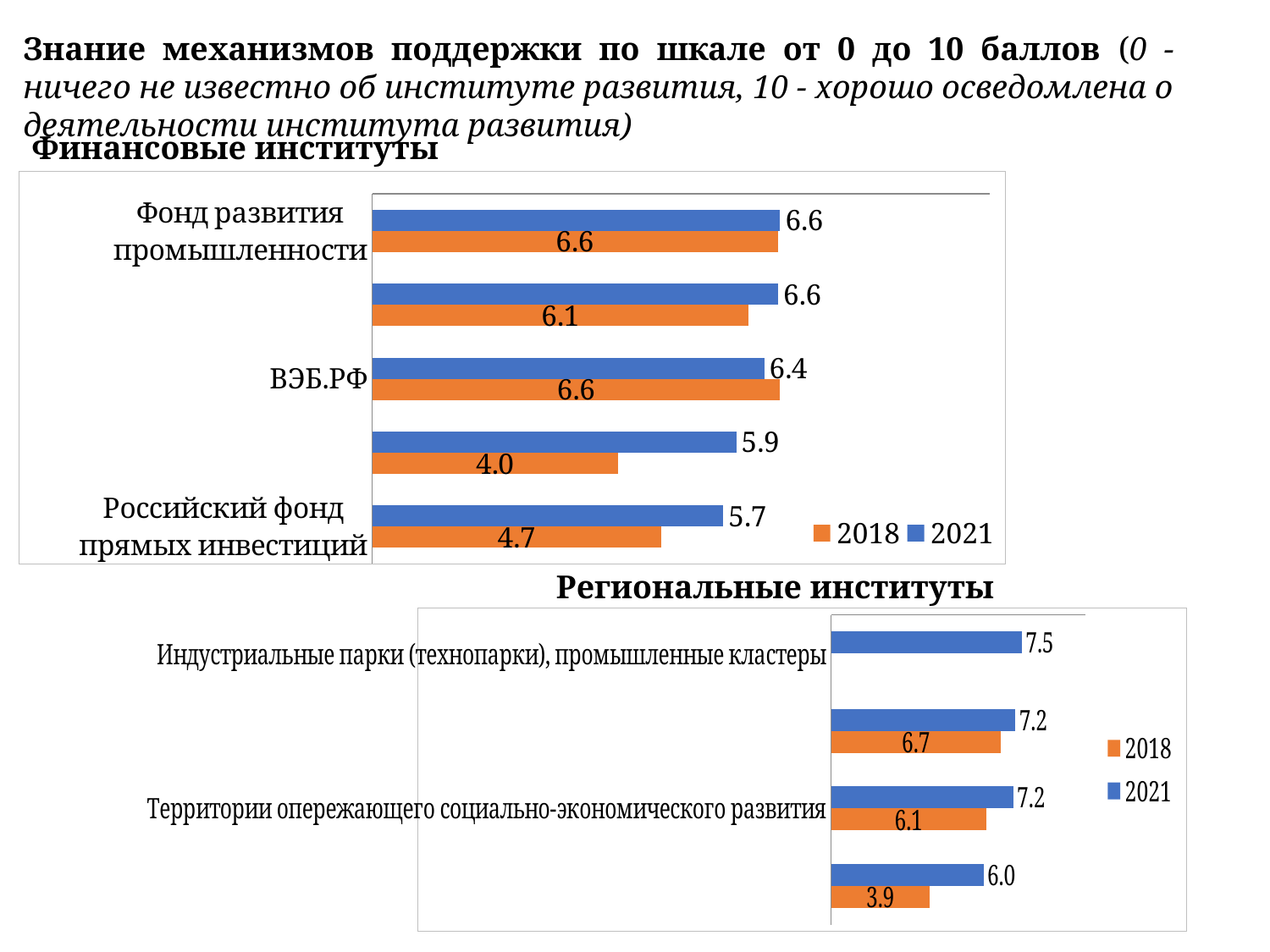
What kind of chart is the 'Региональные институты' chart? Bar chart In the 'Региональные институты' chart, which category has the highest 2021 value? Индустриальные парки (технопарки), промышленные кластеры In the 'Региональные институты' chart, what is the 2021 value for Индустриальные парки (технопарки), промышленные кластеры? 7.5 In the 'Финансовые институты' chart, what is the 2021 value for Фонд развития промышленности? 6.6 How many series does the legend of the 'Финансовые институты' chart list? 2 In the 'Финансовые институты' chart, what is the 2021 value for Российский фонд прямых инвестиций? 5.7 In the 'Финансовые институты' chart, what is the difference between the 2021 and 2018 values for Российский фонд прямых инвестиций? 1.0 In the 'Финансовые институты' chart, what is the 2018 value for ВЭБ.РФ? 6.6 In the 'Региональные институты' chart, what is the difference between the 2021 and 2018 values for Территории опережающего социально-экономического развития? 1.1 Which colour represents the 2018 series in the 'Региональные институты' chart? Orange In the 'Региональные институты' chart, what is the 2018 value for Территории опережающего социально-экономического развития? 6.1 In the 'Финансовые институты' chart, which is larger for ВЭБ.РФ: the 2018 value or the 2021 value? 2018